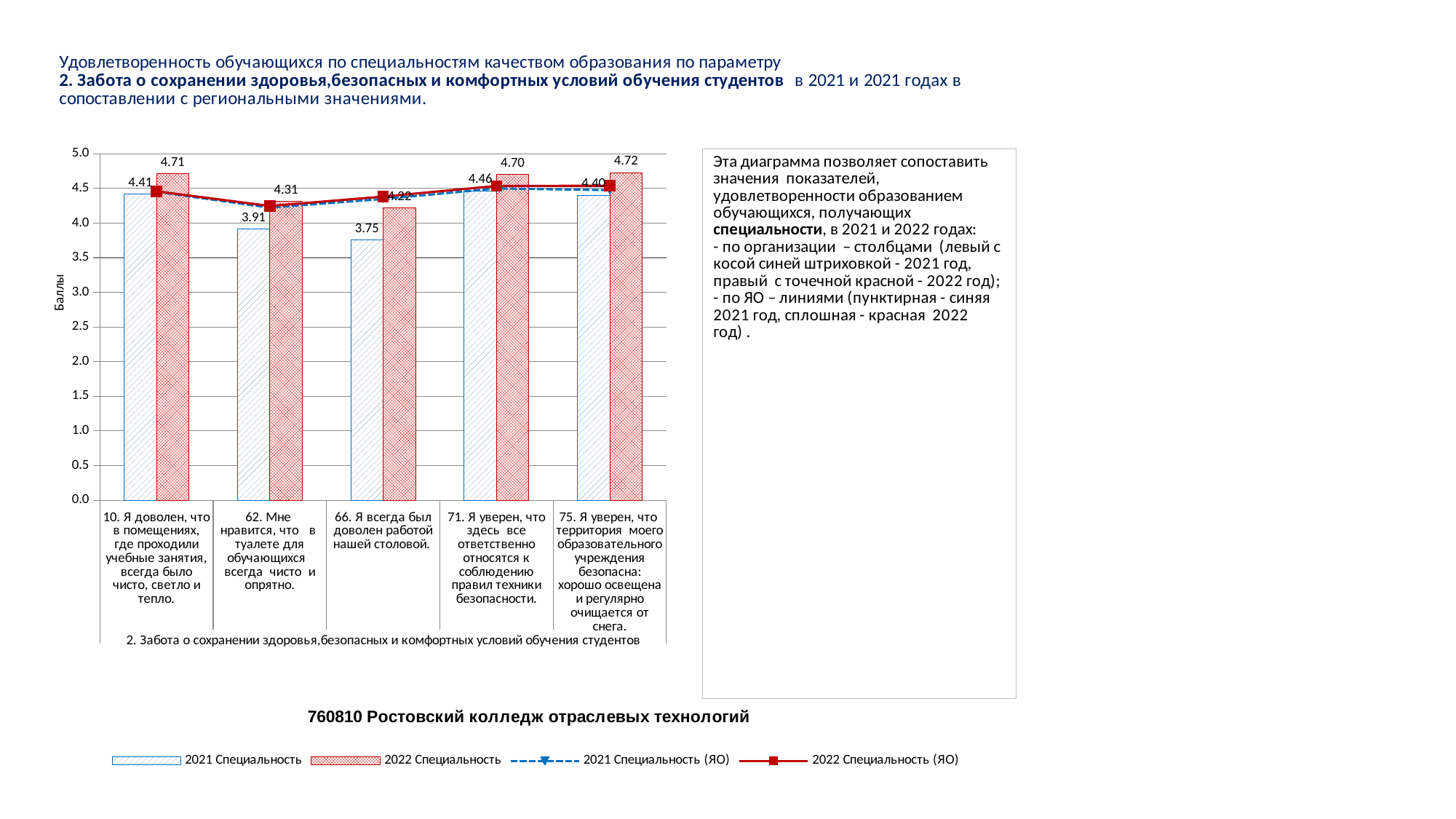
What kind of chart is shown on the slide? Combined bar and line chart How many questions (categories) are shown on the x axis? 5 What is the value of the 2022 Специальность bar for question 62 (в туалете для обучающихся всегда чисто и опрятно)? 4.31 What is the value of the 2022 Специальность bar for question 75 (территория моего образовательного учреждения безопасна)? 4.72 Is the 2021 Специальность value for question 62 greater or less than 4.0? less Which is larger for question 71: the 2021 Специальность bar or the 2022 Специальность bar? 2022 Специальность What is the label of the vertical axis? Баллы Which question has the highest 2022 Специальность bar? 75. Я уверен, что территория моего образовательного учреждения безопасна What is the value of the 2021 Специальность bar for question 66 (Я всегда был доволен работой нашей столовой)? 3.75 How many series does the legend list? 4 Which question has the lowest 2021 Специальность bar? 66. Я всегда был доволен работой нашей столовой. What is the difference between the 2022 and 2021 Специальность bars for question 10 (в помещениях всегда было чисто, светло и тепло)? 0.30